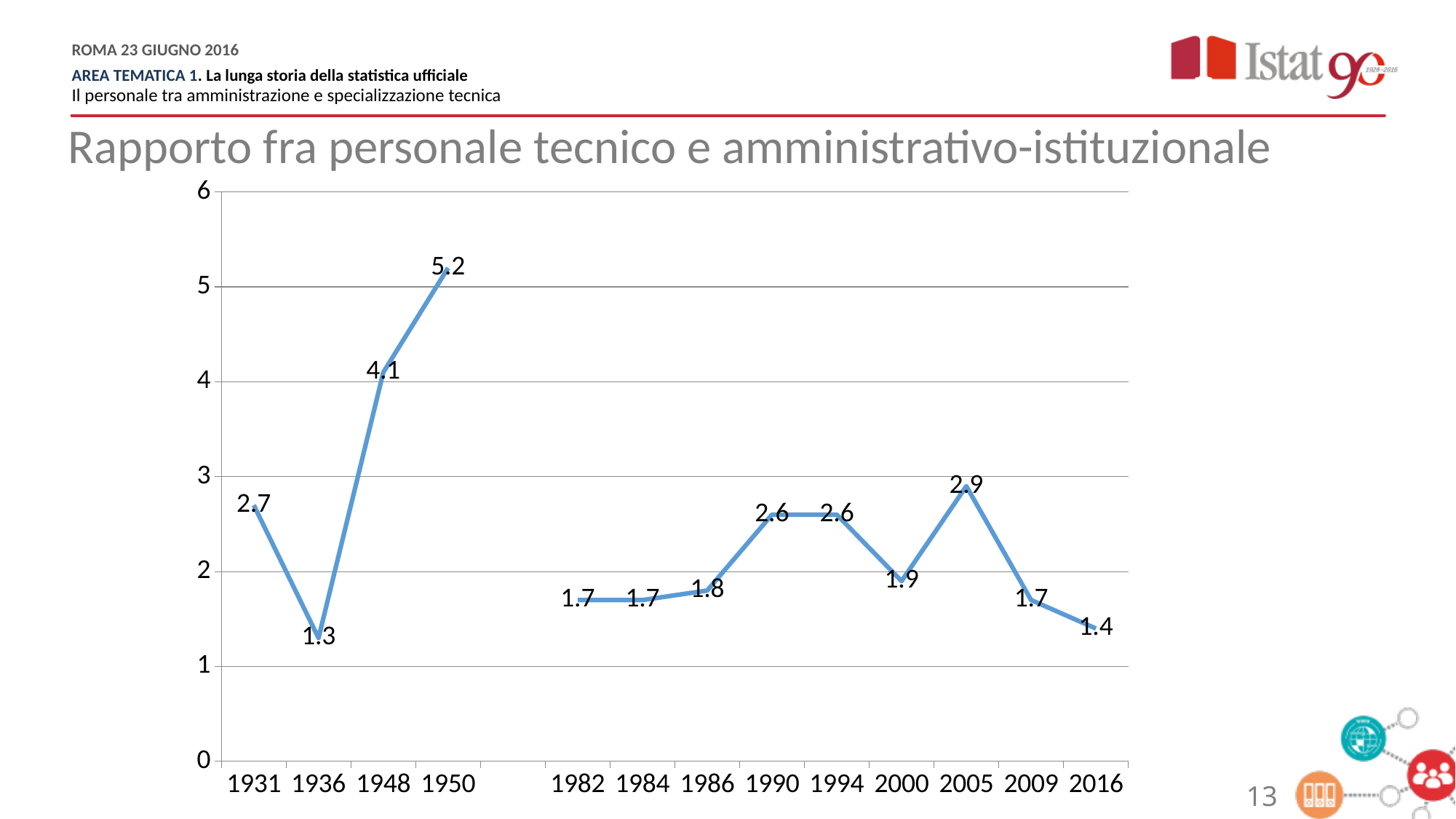
Which year has the highest value? 1950 Which is larger, the value for 1931 or the value for 2005? 2005 What is the value for 1936? 1.3 What kind of chart is shown? line chart Is the value for 1948 greater or less than 4? greater How many years are labelled on the x axis? 13 What is the title of the chart? Rapporto fra personale tecnico e amministrativo-istituzionale What is the value for 2005? 2.9 What is the difference between the values for 1950 and 1948? 1.1 What is the value for 2016? 1.4 What is the value for 1950? 5.2 Which year has the lowest value? 1936